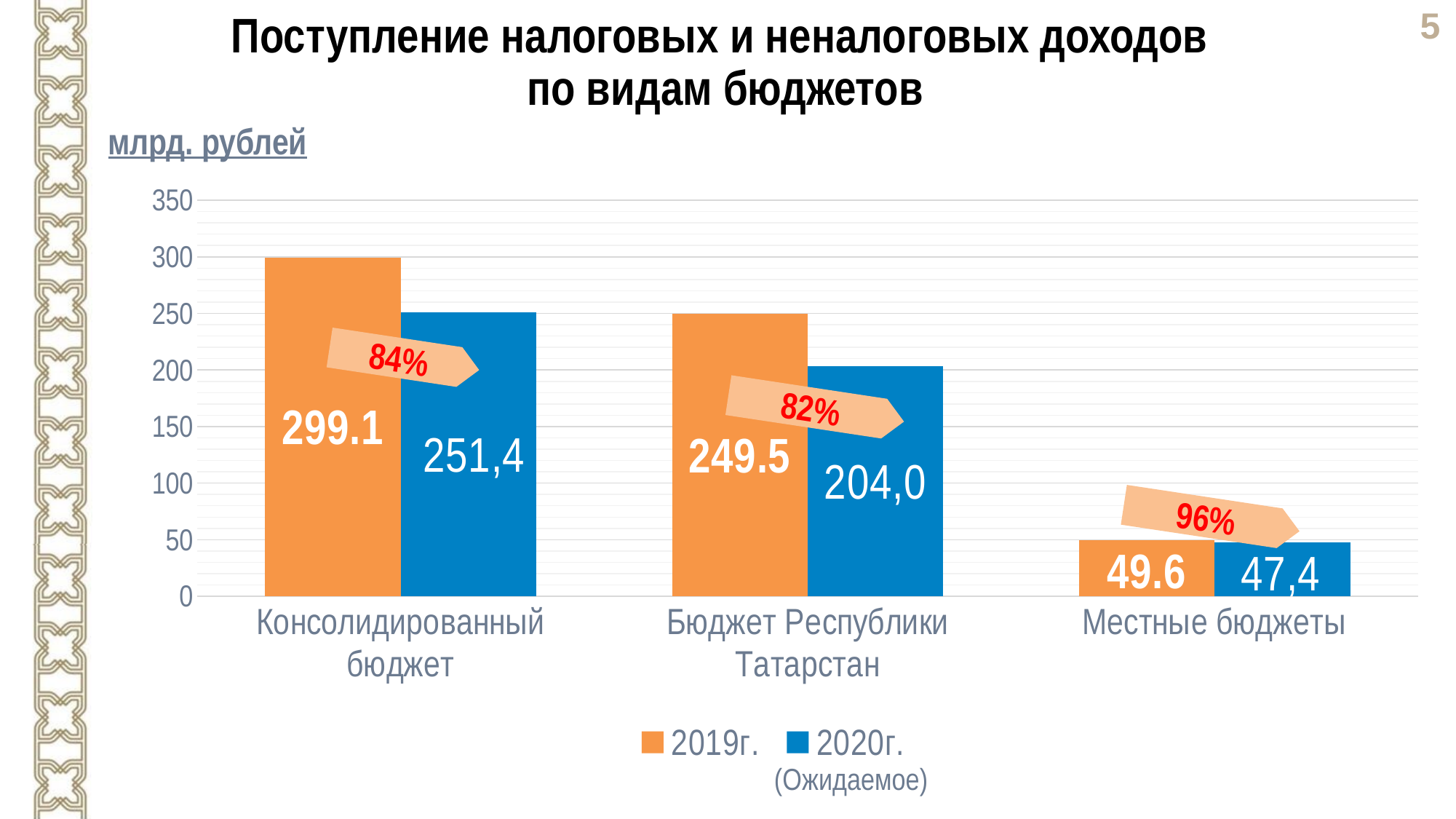
What is the difference between the 2019г. and 2020г. (Ожидаемое) values for Консолидированный бюджет? 47.7 Which is larger for Бюджет Республики Татарстан: the 2019г. value or the 2020г. (Ожидаемое) value? 2019г. Which category has the highest 2019г. value? Консолидированный бюджет How many categories are shown on the x axis? 3 What percentage is shown in the arrow label above Местные бюджеты? 96% What kind of chart is shown on the slide? Bar chart Which category has the lowest 2020г. (Ожидаемое) value? Местные бюджеты What is the 2020г. (Ожидаемое) value for Бюджет Республики Татарстан? 204,0 What is the 2019г. value for Консолидированный бюджет? 299.1 What is the 2019г. value for Местные бюджеты? 49.6 What is the 2020г. (Ожидаемое) value for Местные бюджеты? 47,4 How many series does the legend list? 2